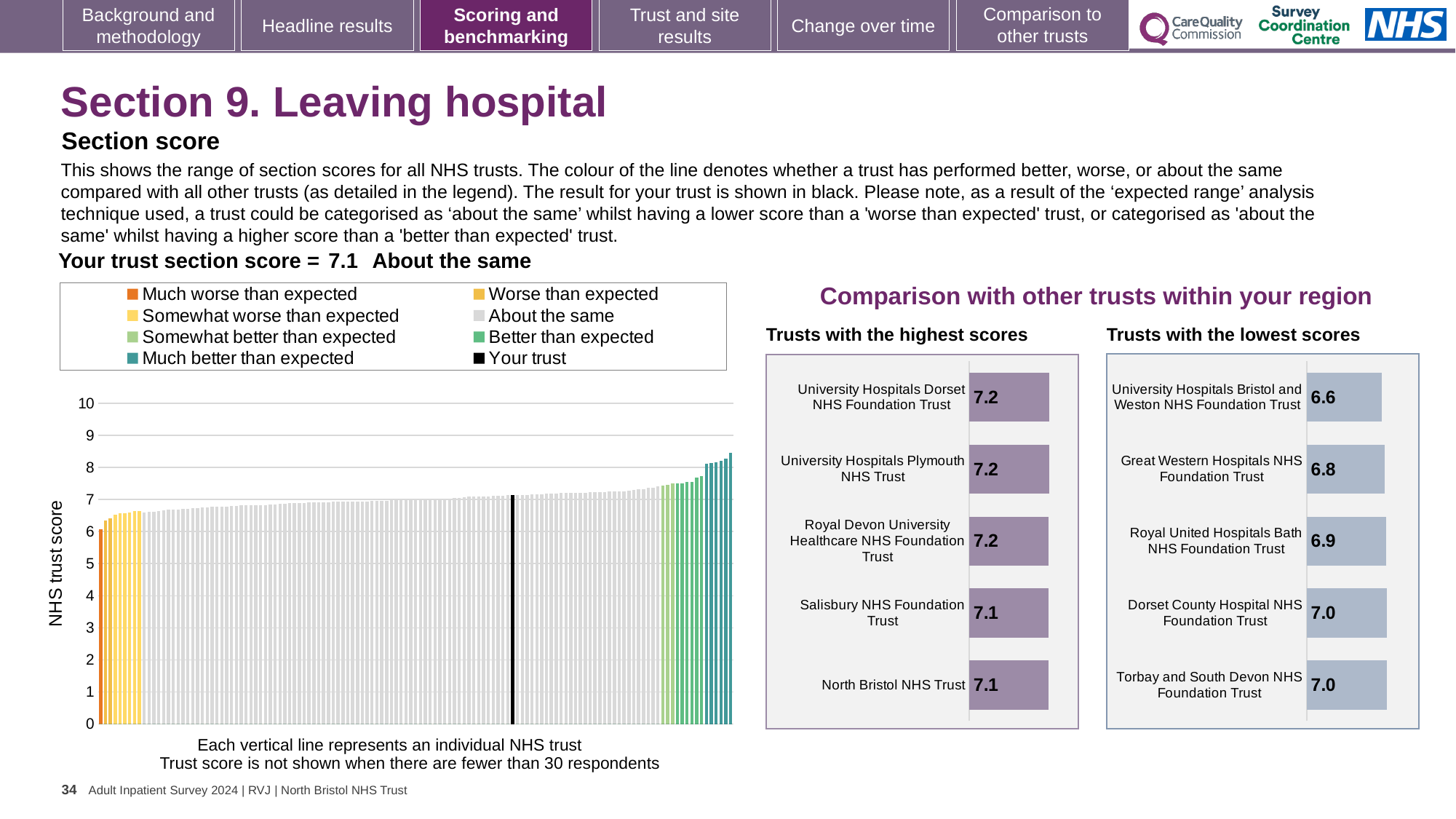
In the 'Trusts with the highest scores' chart, what is the score for Salisbury NHS Foundation Trust? 7.1 In the 'Trusts with the lowest scores' chart, what is the difference between the scores of Dorset County Hospital NHS Foundation Trust and Great Western Hospitals NHS Foundation Trust? 0.2 In the main chart on the left showing all NHS trusts, do the trust scores rise or fall from left to right? Rise In the 'Trusts with the highest scores' chart, what is the score for North Bristol NHS Trust? 7.1 What is the section score for your trust shown on the slide? 7.1 How many trusts are shown in the 'Trusts with the highest scores' chart? 5 How many entries does the legend of the main chart on the left list? 8 In the 'Trusts with the lowest scores' chart, which has the higher score: Great Western Hospitals NHS Foundation Trust or Royal United Hospitals Bath NHS Foundation Trust? Royal United Hospitals Bath NHS Foundation Trust In the 'Trusts with the lowest scores' chart, what is the difference between the scores of Royal United Hospitals Bath NHS Foundation Trust and University Hospitals Bristol and Weston NHS Foundation Trust? 0.3 In the 'Trusts with the lowest scores' chart, what is the score for Great Western Hospitals NHS Foundation Trust? 6.8 In the 'Trusts with the lowest scores' chart, which trust has the lowest score? University Hospitals Bristol and Weston NHS Foundation Trust What kind of chart is the 'Trusts with the highest scores' chart? Bar chart